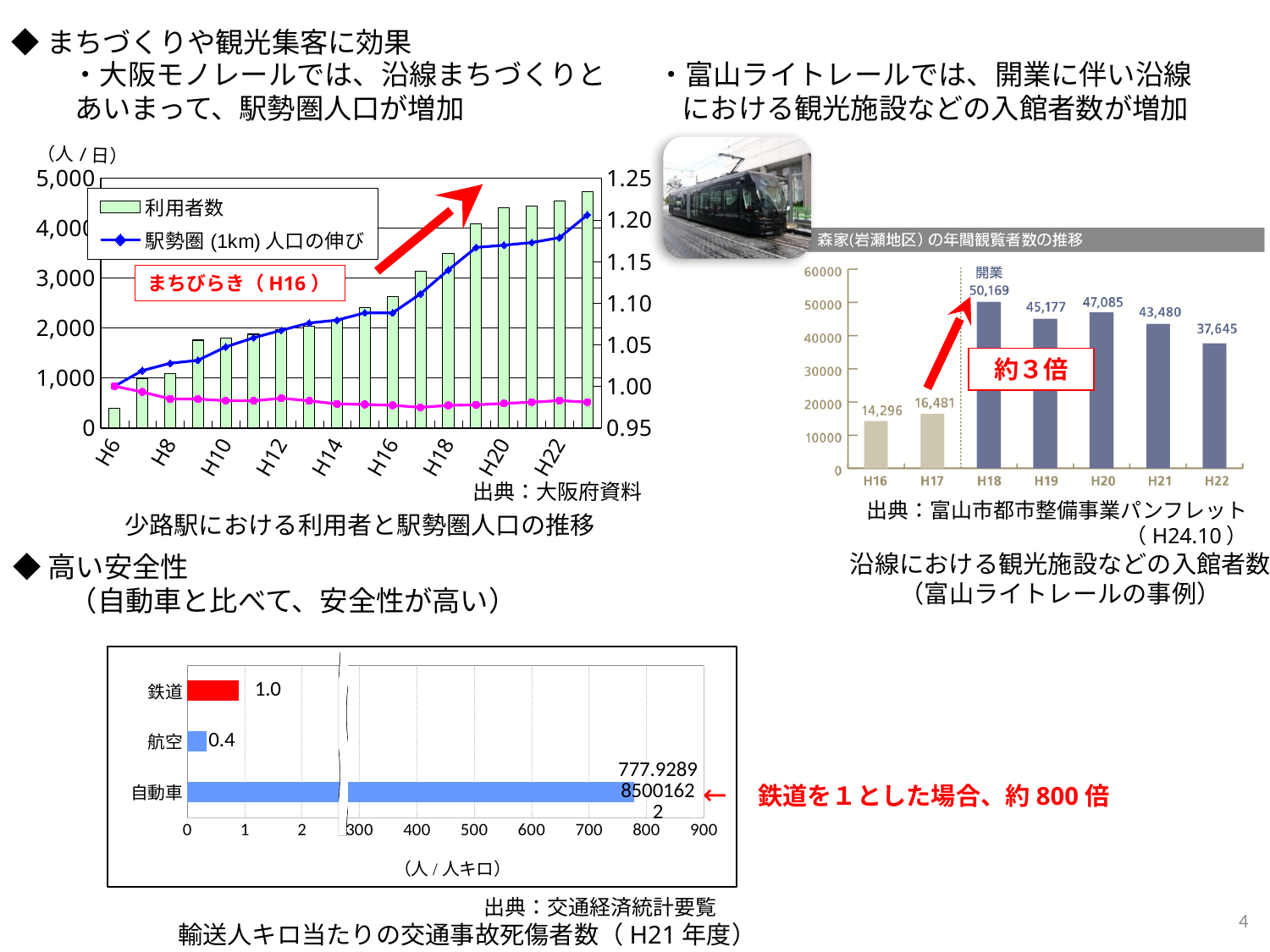
In the bottom chart 輸送人キロ当たりの交通事故死傷者数, which category has the highest value? 自動車 In the chart titled 森家(岩瀬地区)の年間観覧者数の推移, which year has the lowest value? H16 In the bottom chart 輸送人キロ当たりの交通事故死傷者数, what is the value for 航空? 0.4 In the chart titled 森家(岩瀬地区)の年間観覧者数の推移, how many years are shown on the x axis? 7 In the chart titled 森家(岩瀬地区)の年間観覧者数の推移, which year has the highest value? H18 In the top-left chart 少路駅における利用者と駅勢圏人口の推移, how many series does the legend list? 2 In the chart titled 森家(岩瀬地区)の年間観覧者数の推移, what is the value for H18? 50,169 In the chart titled 森家(岩瀬地区)の年間観覧者数の推移, what is the difference between the values for H18 and H17? 33,688 In the bottom chart 輸送人キロ当たりの交通事故死傷者数, what is the value for 鉄道? 1.0 In the top-left chart 少路駅における利用者と駅勢圏人口の推移, does the 駅勢圏(1km)人口の伸び line rise or fall from H6 to H23? rise In the chart titled 森家(岩瀬地区)の年間観覧者数の推移, which is larger, the value for H20 or the value for H21? H20 In the chart titled 森家(岩瀬地区)の年間観覧者数の推移, what is the value for H16? 14,296